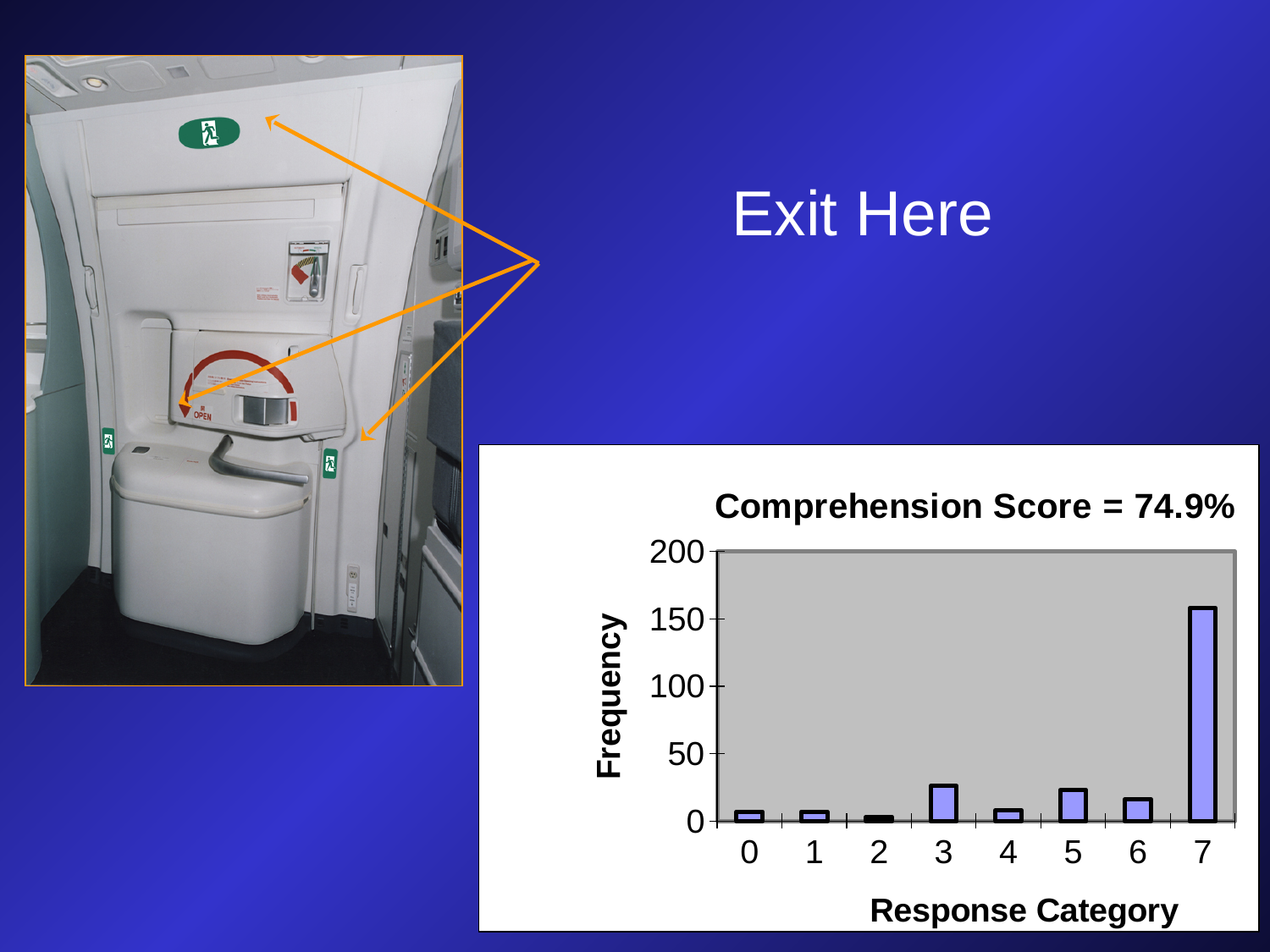
Which has a higher frequency, response category 7 or response category 3? 7 Which response category has the highest frequency? 7 What kind of chart is shown on the slide? bar chart What is the label of the y axis of the chart? Frequency Which has a higher frequency, response category 3 or response category 2? 3 Which response category has the lowest frequency? 2 Which has a higher frequency, response category 6 or response category 4? 6 How many response categories are shown on the x axis of the chart? 8 Is the frequency for response category 3 greater or less than 50? less Is the frequency for response category 7 greater or less than 150? greater Is the frequency for response category 7 greater or less than 200? less What is the title of the chart? Comprehension Score = 74.9%